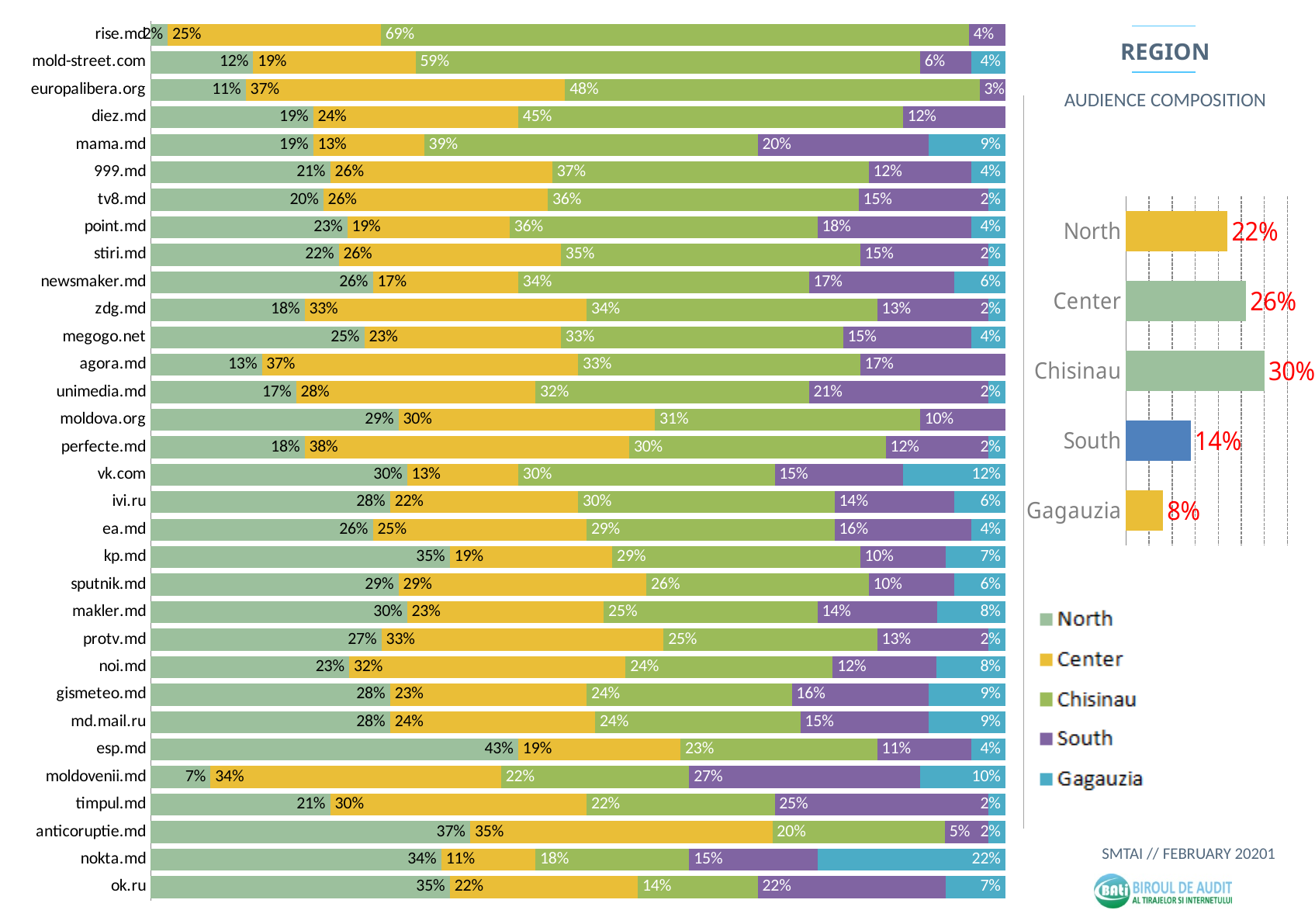
In the large stacked bar chart on the left, what is the South share for moldovenii.md? 27% How many series does the legend list for the large stacked bar chart on the left? 5 How many websites are shown in the large stacked bar chart on the left? 32 In the REGION chart on the right, which region has the highest value? Chisinau In the REGION chart on the right, what is the difference between the values for Chisinau and Gagauzia? 22 percentage points In the large stacked bar chart on the left, what is the Gagauzia share for nokta.md? 22% In the large stacked bar chart on the left, which has a larger North share, ok.ru or moldovenii.md? ok.ru What kind of chart is the large chart on the left? Stacked bar chart In the REGION chart on the right, which region has the lowest value? Gagauzia In the large stacked bar chart on the left, what is the Chisinau share for rise.md? 69% In the REGION chart on the right, what is the value for Chisinau? 30% In the REGION chart on the right, which is larger, the value for North or the value for Center? Center